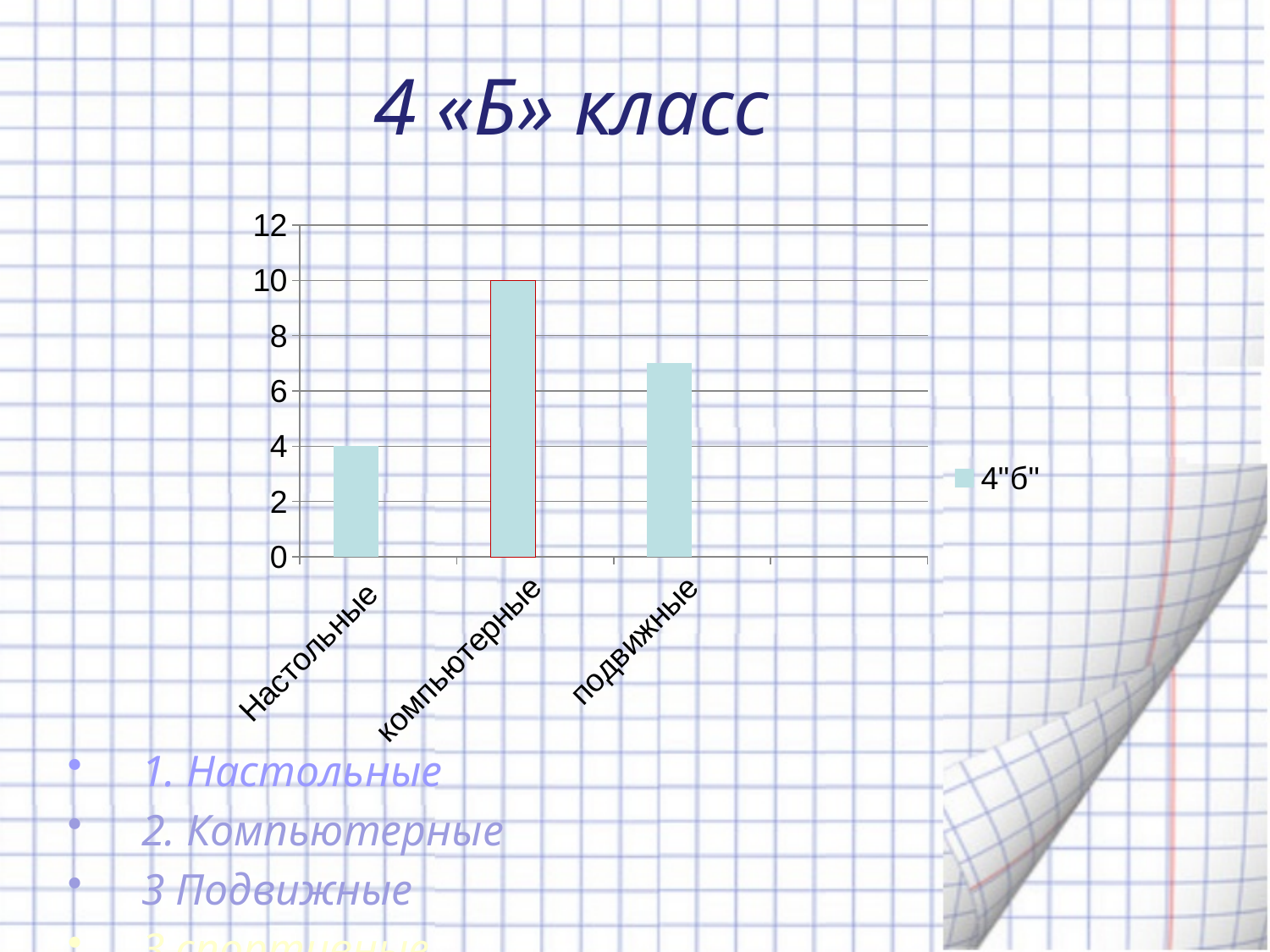
What is the value for компьютерные? 10 What is the difference between the values for компьютерные and настольные? 6 Which category has the lowest value? настольные Is the value for подвижные greater or less than 8? less What is the value for настольные? 4 Which is larger, the value for подвижные or the value for настольные? подвижные Which category has the highest value? компьютерные How many categories are shown on the x axis of the chart? 3 Is the value for подвижные greater or less than 6? greater What is the legend entry of the chart? 4"б" How many series does the chart legend list? 1 What kind of chart is shown on the slide? bar chart